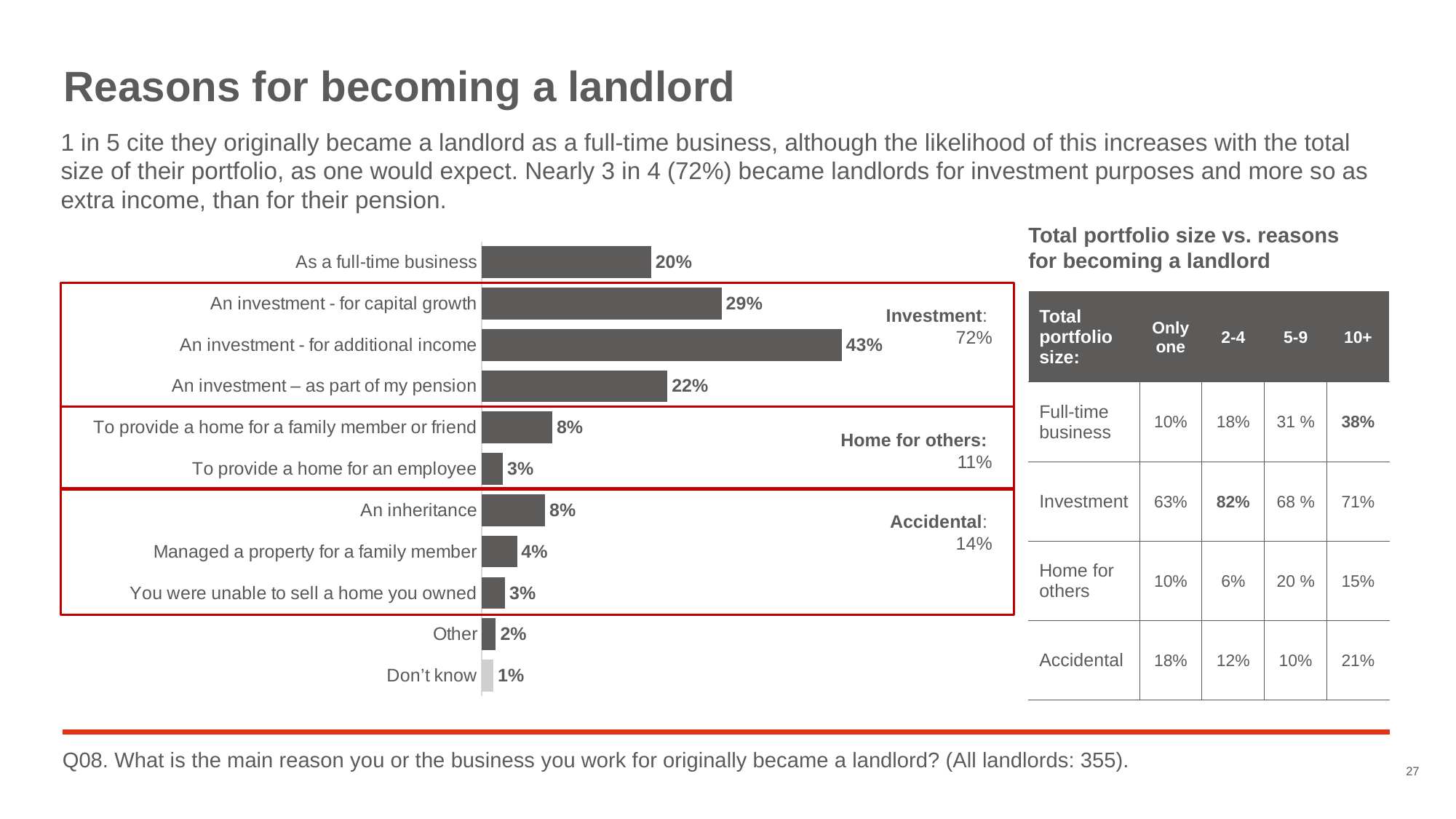
What type of chart is used to show the reasons for becoming a landlord? Bar chart Which is larger: the value for 'An inheritance' or the value for 'Managed a property for a family member'? An inheritance What is the title of the table to the right of the bar chart? Total portfolio size vs. reasons for becoming a landlord How many reason categories are shown in the bar chart? 11 What is the difference in percentage points between 'An investment - for capital growth' and 'An investment – as part of my pension'? 7 What combined percentage is shown for the 'Investment' group of reasons? 72% Which reason for becoming a landlord has the highest percentage? An investment - for additional income What is the value for 'To provide a home for an employee'? 3% What percentage of landlords cite 'An investment - for additional income' as their main reason for becoming a landlord? 43% What percentage of landlords became a landlord 'As a full-time business'? 20% What combined percentage is shown for the 'Accidental' group of reasons? 14% Which reason for becoming a landlord has the lowest percentage? Don't know